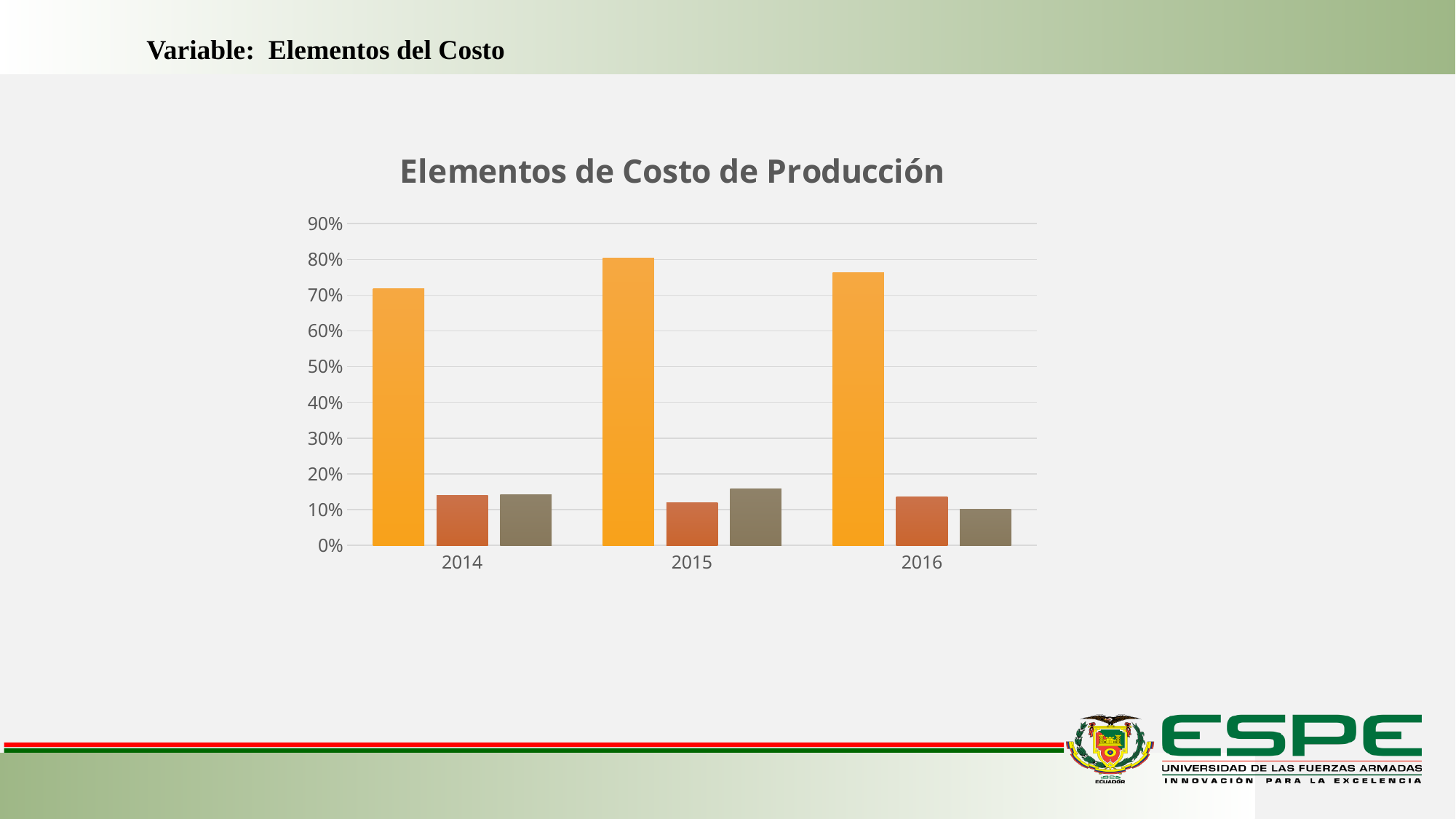
Which is taller in 2015, the grey-brown bar or the red-brown bar? the grey-brown bar Is the orange bar for 2014 greater or less than 60%? greater What is the title of the chart? Elementos de Costo de Producción Which is taller in 2015, the orange bar or the grey-brown bar? the orange bar In which year is the orange bar the shortest? 2014 Is the grey-brown bar for 2015 greater or less than 10%? greater In which year is the orange bar the tallest? 2015 Is the orange bar for 2015 greater or less than 70%? greater What type of chart is shown on the slide? bar chart How many years are shown on the x axis of the chart? 3 How many bars are plotted for each year in the chart? 3